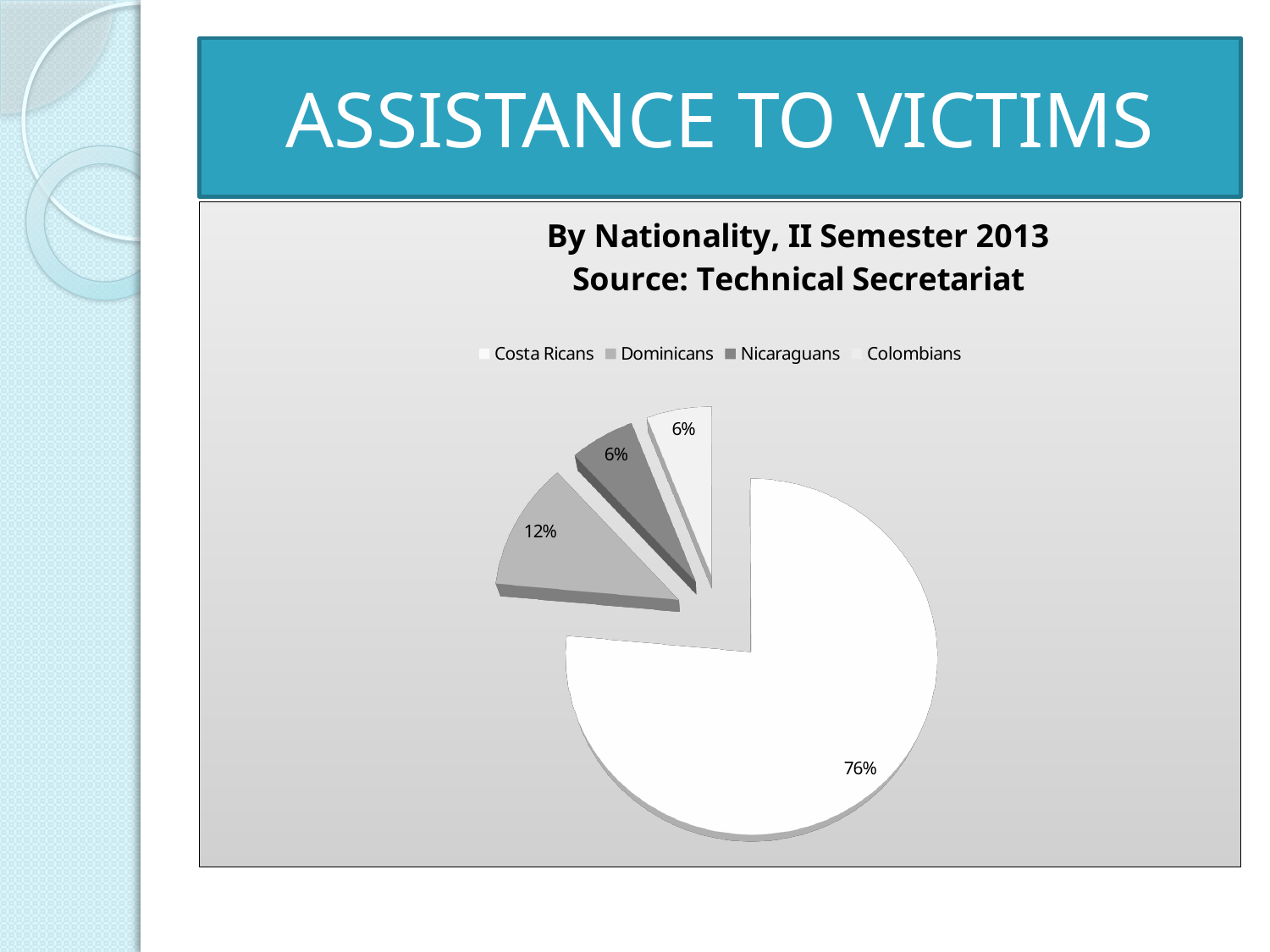
What is the value shown for Nicaraguans in the pie chart? 6% What percentage of the pie chart do Dominicans represent? 12% Which nationality has the largest slice of the pie chart? Costa Ricans How many entries does the chart legend list? 4 What is the value shown for Colombians in the pie chart? 6% How many slices does the pie chart have? 4 By how many percentage points does the Costa Ricans share exceed the Dominicans share? 64 By how many percentage points does the Dominicans share exceed the Colombians share? 6 What type of chart is shown on the slide? Pie chart What share of the pie chart is Costa Ricans? 76% What is the title of the chart? By Nationality, II Semester 2013 Source: Technical Secretariat Which is larger in the pie chart, the share for Dominicans or the share for Nicaraguans? Dominicans